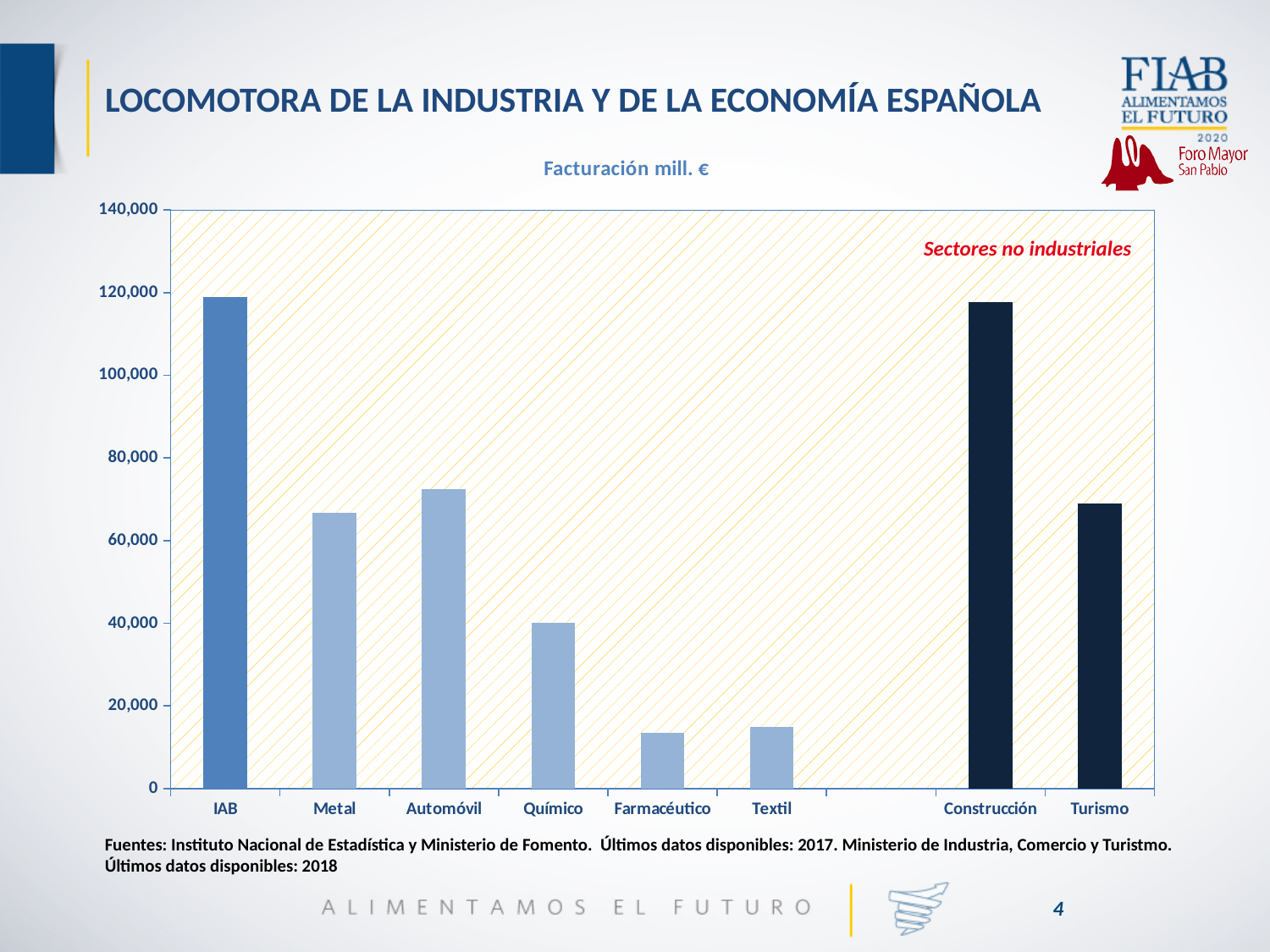
Is the value for IAB greater or less than 100,000? greater Which has a larger value, Turismo or Textil? Turismo Is the value for Químico greater or less than 60,000? less Is the value for Automóvil greater or less than 80,000? less Which has a larger value, Metal or Químico? Metal How many categories are plotted on the x axis of the chart? 8 What is the title of the chart? Facturación mill. € What kind of chart is shown on the slide? Bar chart Which two categories are labelled as 'Sectores no industriales' on the chart? Construcción and Turismo